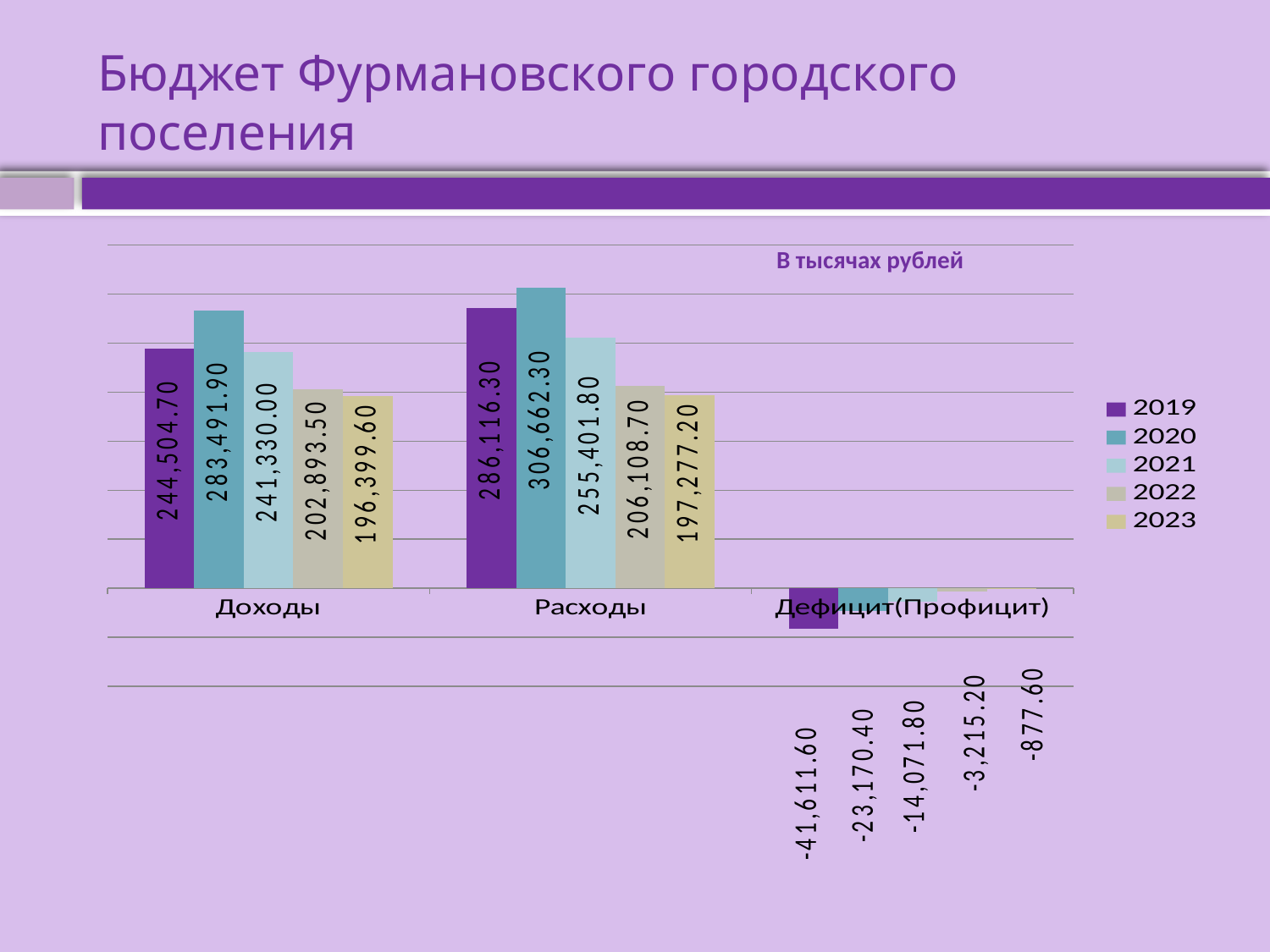
What is the value for Дефицит(Профицит) in 2019? -41,611.60 What unit is stated in the chart's note? В тысячах рублей Do the Доходы values rise or fall from 2020 to 2023? fall What kind of chart is shown on the slide? bar chart What is the value for Расходы in 2023? 197,277.20 Which is larger, Доходы in 2019 or Доходы in 2021? Доходы in 2019 How many series does the legend list? 5 Which year has the highest value for Расходы? 2020 How many categories are shown on the x axis? 3 What is the difference between Расходы and Доходы in 2020? 23,170.40 Which year has the lowest value for Доходы? 2023 What is the value for Доходы in 2020? 283,491.90